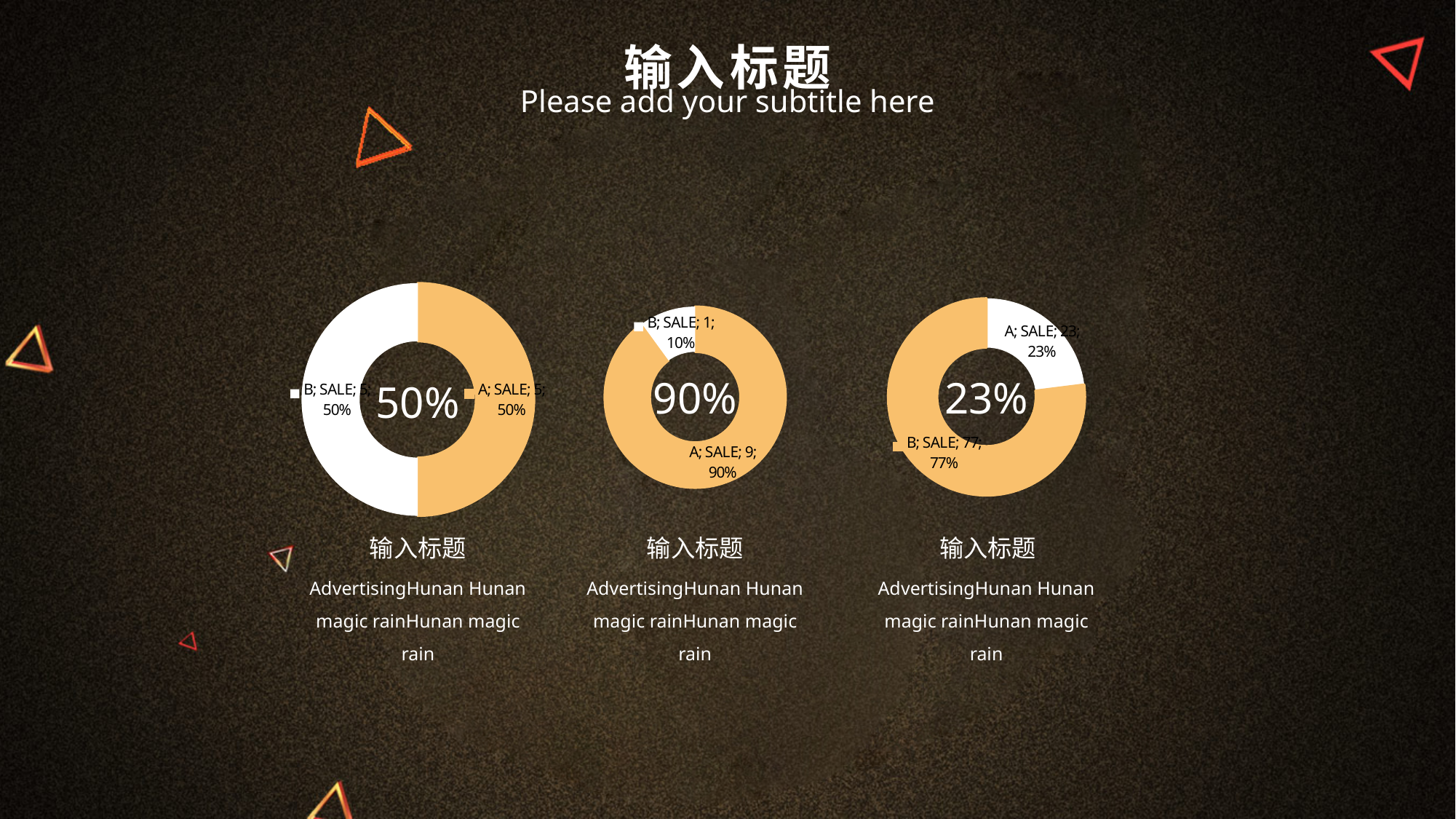
In the left doughnut chart, what is the SALE value for category A? 5 What kind of chart is shown in the middle of the slide? Doughnut chart In the middle doughnut chart, what is the SALE value for category B? 1 In the middle doughnut chart, what is the difference between the SALE values of A and B? 8 In the right doughnut chart, what share of the pie does category A hold? 23% In the middle doughnut chart, which category has the largest slice? A In the left doughnut chart, what share of the pie does category B hold? 50% In the middle doughnut chart, what share of the pie does category A hold? 90% In the right doughnut chart, is the SALE value for A or for B larger? B In the right doughnut chart, which category has the smallest slice? A In the right doughnut chart, what is the SALE value for category B? 77 How many slices does the left doughnut chart have? 2